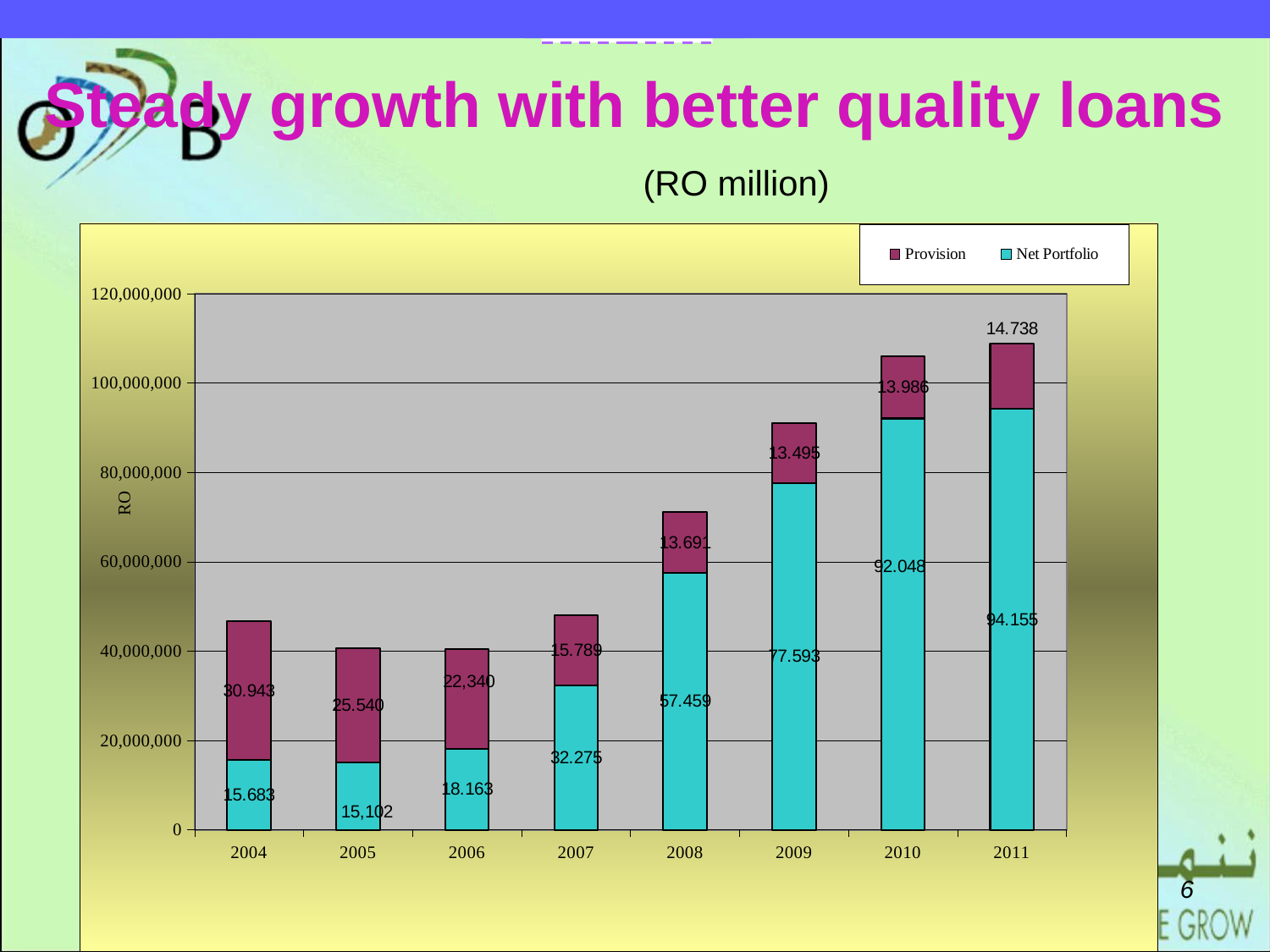
How many series does the legend list? 2 What is the difference between the Net Portfolio values for 2010 and 2009? 14.455 Does the Net Portfolio value rise or fall from 2004 to 2011? Rise How many years are shown on the x axis? 8 Which year has the highest Net Portfolio value? 2011 What is the Net Portfolio value for 2011? 94.155 What kind of chart is shown on the slide? Stacked bar chart What colour represents Provision in the legend? Purple Which year has the highest Provision value? 2004 Is the total height of the 2007 bar greater or less than 60,000,000? less What is the Provision value for 2004? 30.943 Which is larger, the Provision value for 2008 or for 2009? 2008